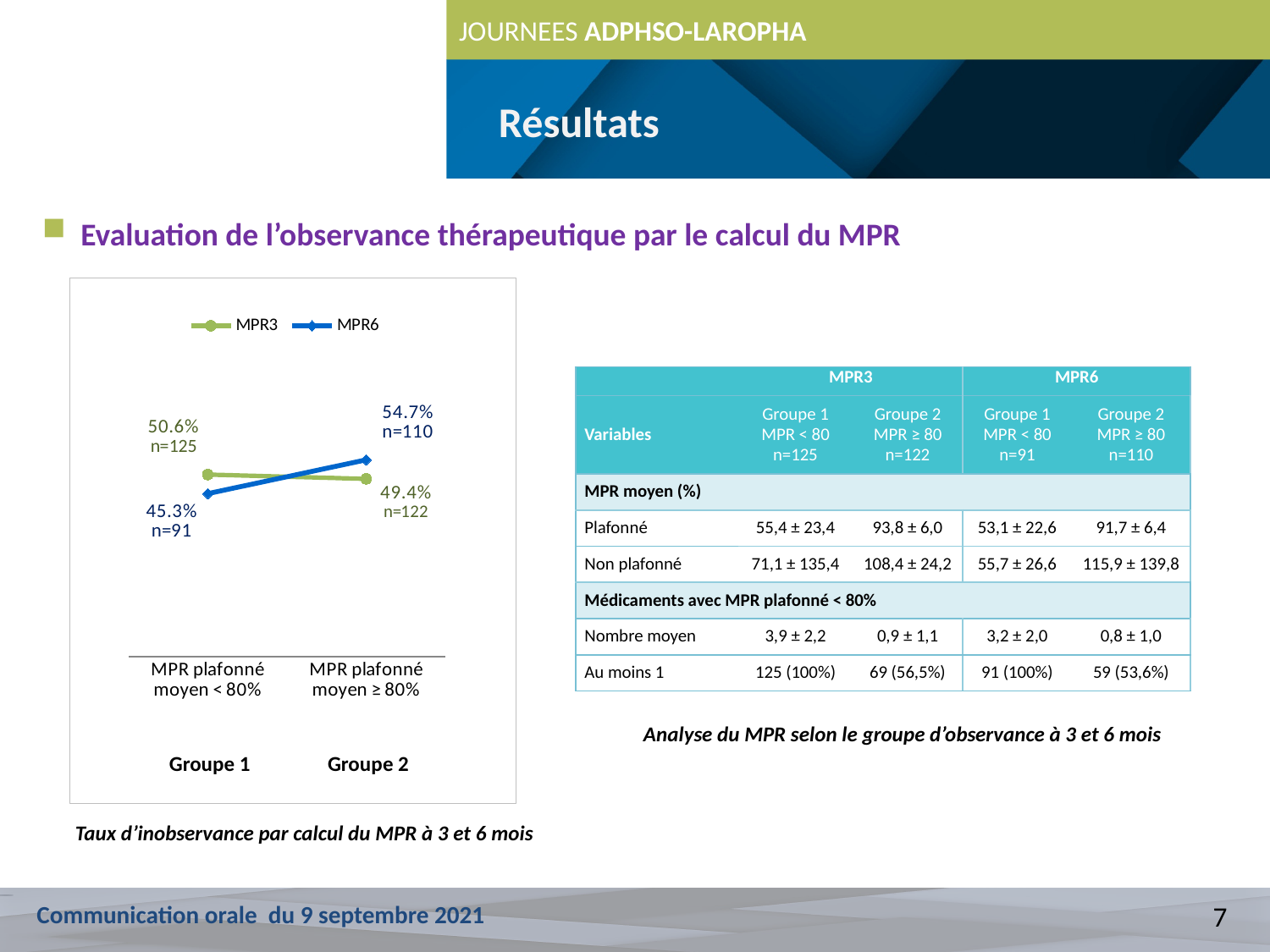
Does the MPR6 series rise or fall from Groupe 1 to Groupe 2? rise What is the difference between the MPR6 values for Groupe 2 and Groupe 1? 9.4% What is the MPR6 value for Groupe 1? 45.3% What is the MPR3 value for Groupe 2? 49.4% What is the MPR3 value for Groupe 1? 50.6% How many series does the chart legend list? 2 What kind of chart is shown on the slide? line chart How many groups (categories) are plotted on the x axis of the chart? 2 What are the two series named in the chart legend? MPR3 and MPR6 What is the MPR6 value for Groupe 2? 54.7% Which series has the higher value for Groupe 2, MPR3 or MPR6? MPR6 What is the n shown for the MPR6 point of Groupe 2? n=110